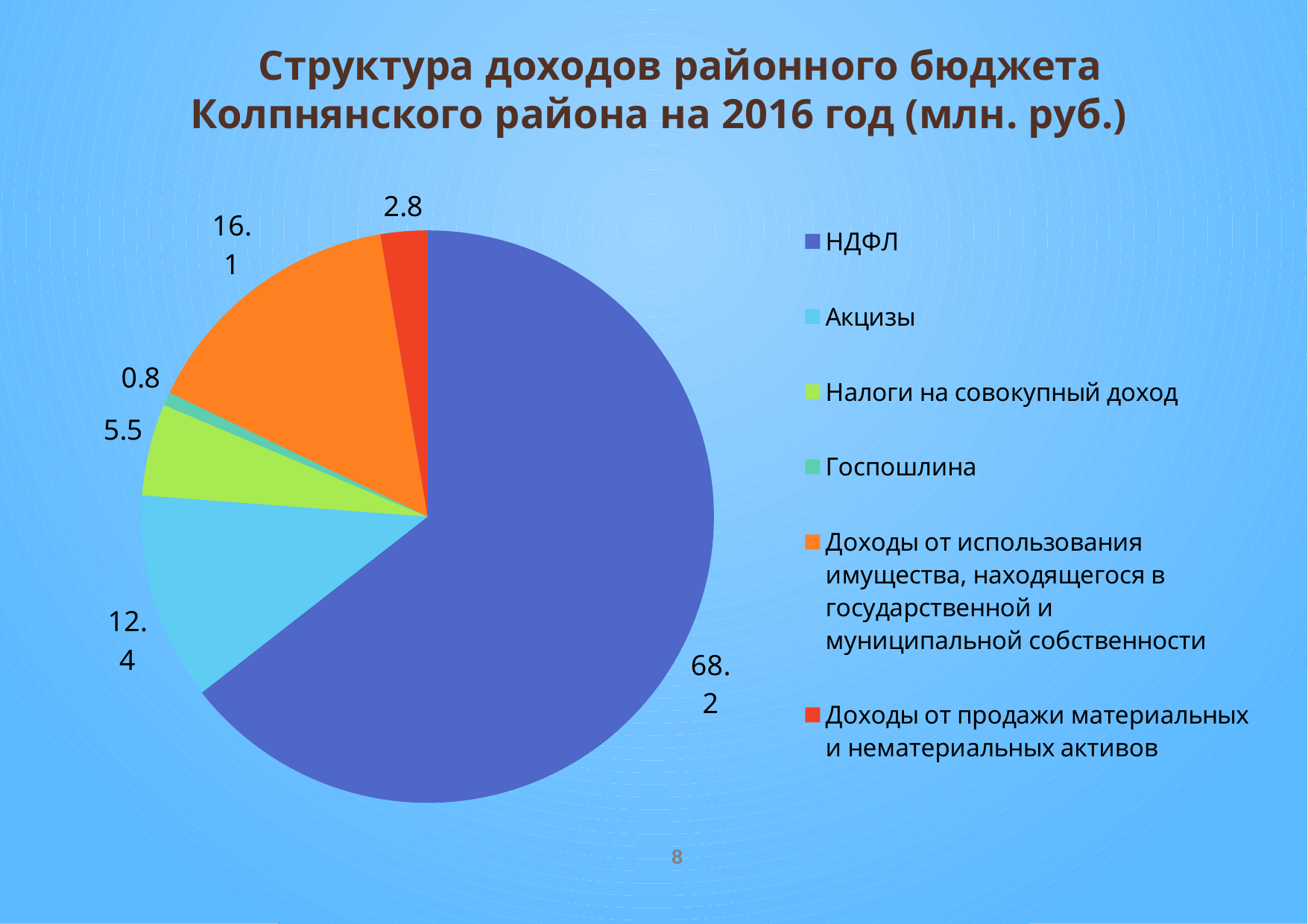
What is the value for Доходы от использования имущества, находящегося в государственной и муниципальной собственности? 16.1 What is the value for НДФЛ? 68.2 Which is larger: the value for Акцизы or the value for Доходы от использования имущества, находящегося в государственной и муниципальной собственности? Доходы от использования имущества, находящегося в государственной и муниципальной собственности What is the difference between the values for НДФЛ and Акцизы? 55.8 What is the value for Налоги на совокупный доход? 5.5 Which category has the smallest slice of the pie? Госпошлина What is the value for Акцизы? 12.4 What is the value for Доходы от продажи материальных и нематериальных активов? 2.8 How many categories does the legend list? 6 What is the value for Госпошлина? 0.8 What kind of chart is shown on the slide? pie chart Which category has the largest slice of the pie? НДФЛ